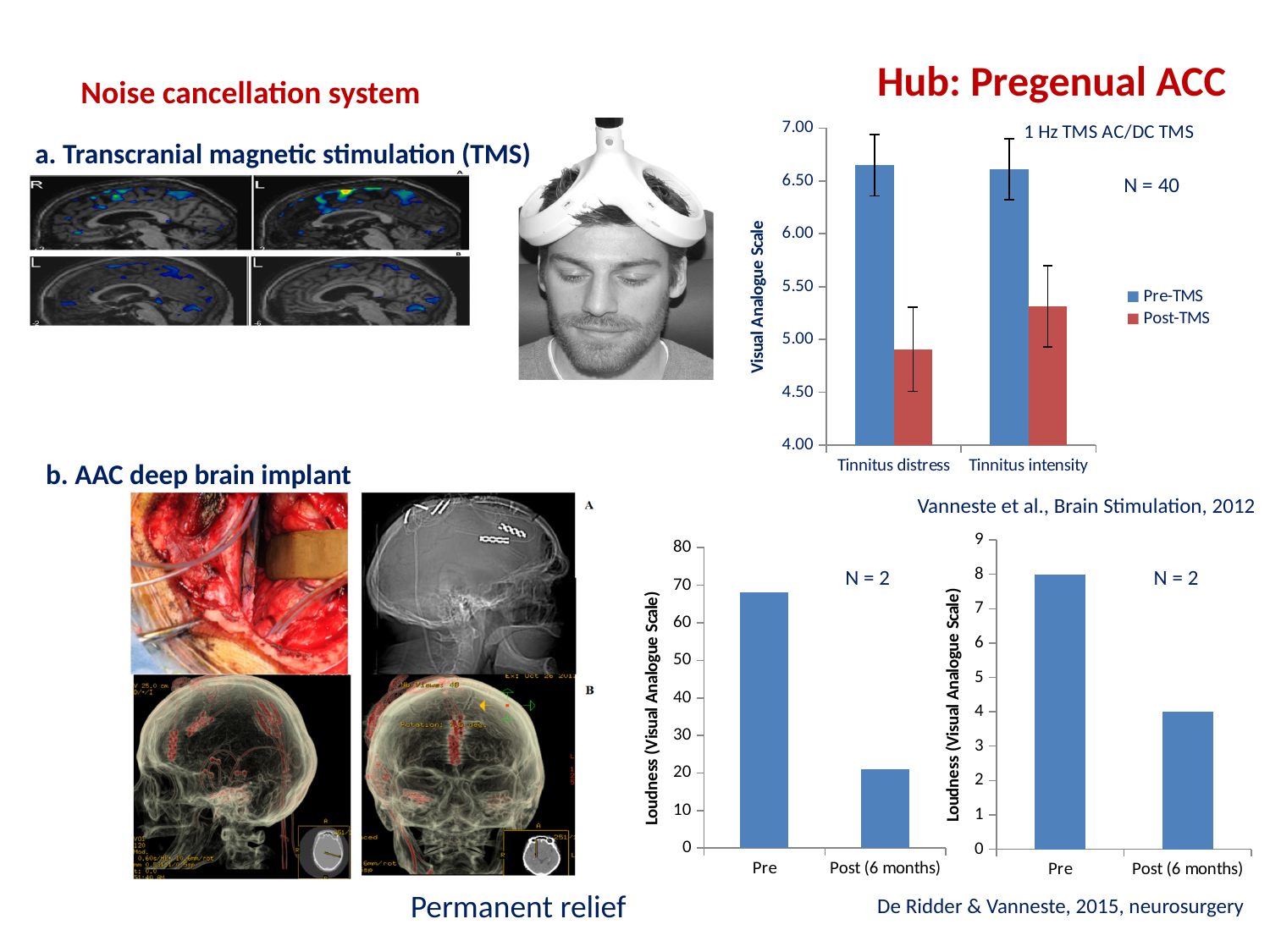
What type of chart is the bottom-middle chart with the Pre and Post (6 months) bars on a 0–80 scale? bar chart In the bottom-right chart (Loudness, 0–9 scale), what is the value for Pre? 8 In the top-right chart (Hub: Pregenual ACC), how many series does the legend list? 2 In the top-right chart (Hub: Pregenual ACC), which series has the larger value for Tinnitus intensity, Pre-TMS or Post-TMS? Pre-TMS In the top-right chart (Hub: Pregenual ACC), how many categories are shown on the x axis? 2 In the bottom-middle chart (Loudness, 0–80 scale), is the value for Post (6 months) greater or less than 30? less In the top-right chart (Hub: Pregenual ACC), what are the two series named in the legend? Pre-TMS and Post-TMS In the bottom-right chart (Loudness, 0–9 scale), what is the value for Post (6 months)? 4 In the bottom-right chart (Loudness, 0–9 scale), what is the difference between the Pre and Post (6 months) values? 4 In the top-right chart (Hub: Pregenual ACC), is the Post-TMS value for Tinnitus distress greater or less than 5.00? less In the top-right chart (Hub: Pregenual ACC), is the Pre-TMS value for Tinnitus intensity greater or less than 6.50? greater